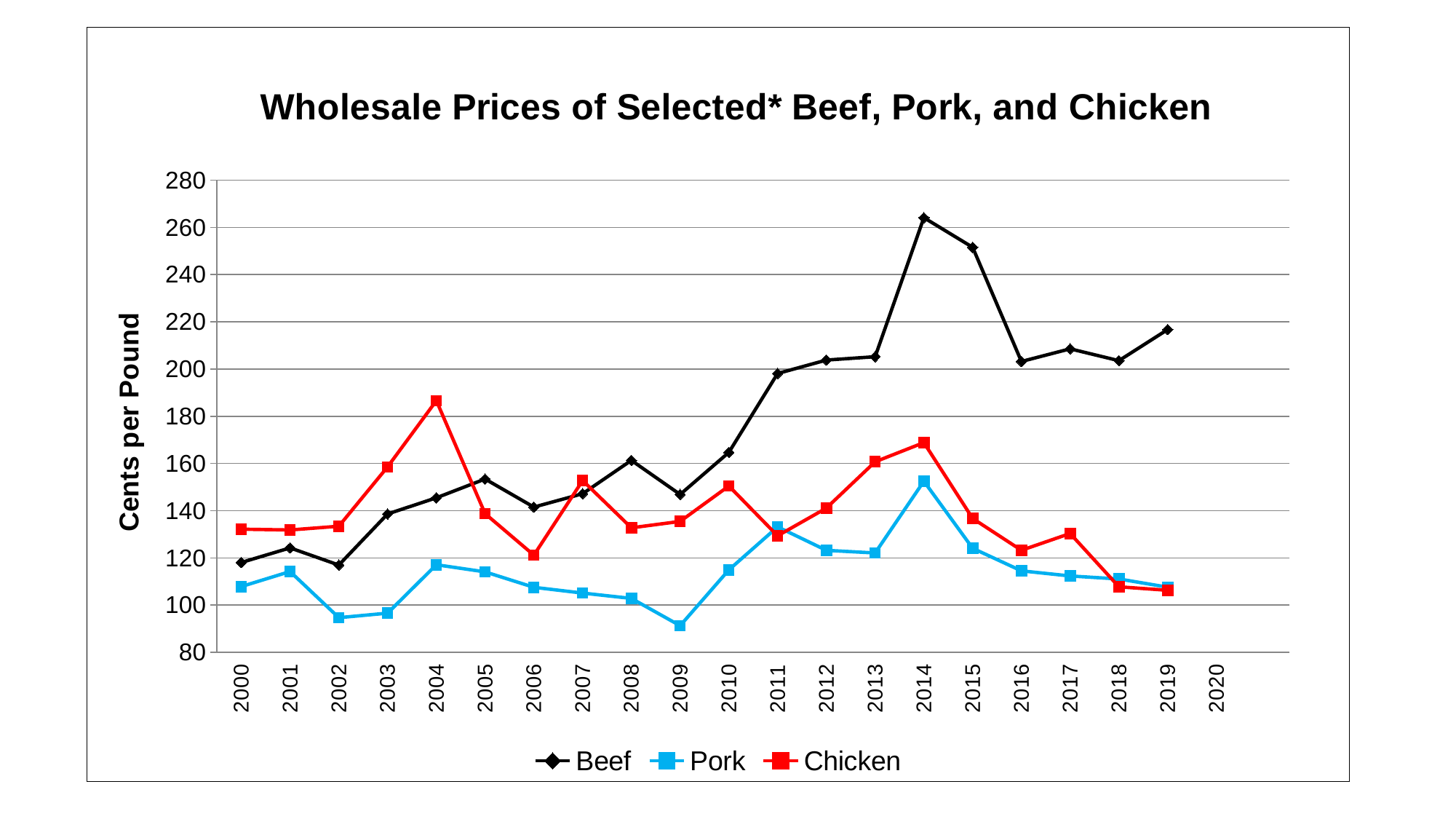
Is the value for Beef in 2014 greater or less than 240? greater In which year does the Pork line reach its lowest value? 2009 What kind of chart is shown on the slide? line chart Does the Beef line rise or fall from 2010 to 2014? rise Does the Pork line rise or fall from 2014 to 2019? fall How many series does the legend list? 3 In 2004, which is larger: the Chicken value or the Beef value? Chicken Is the value for Chicken in 2004 greater or less than 180? greater Is the value for Pork in 2009 greater or less than 100? less In which year does the Beef line reach its highest value? 2014 What is the title of the vertical axis? Cents per Pound In which year does the Chicken line reach its highest value? 2004